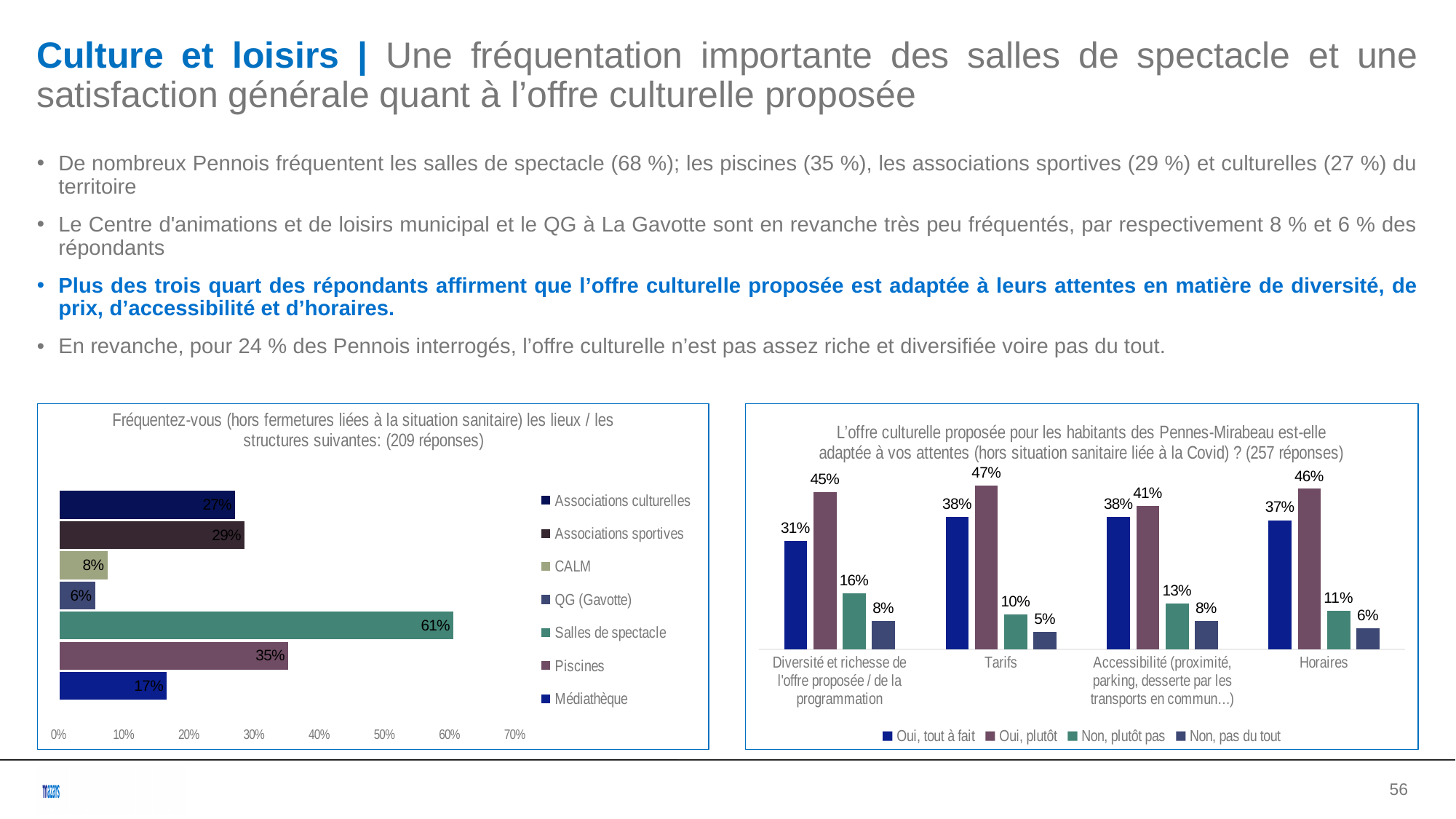
In the right chart (L'offre culturelle proposée...), what is the difference between 'Non, plutôt pas' for Diversité et richesse de l'offre proposée and for Tarifs? 6% In the left chart (Fréquentez-vous...), which place or structure has the lowest value? QG (Gavotte) What kind of chart is the left chart (Fréquentez-vous...)? Bar chart In the right chart (L'offre culturelle proposée...), what is the value of 'Non, pas du tout' for Horaires? 6% In the left chart (Fréquentez-vous...), which place or structure has the highest value? Salles de spectacle In the right chart (L'offre culturelle proposée...), what is the value of 'Oui, plutôt' for Tarifs? 47% In the left chart (Fréquentez-vous...), what is the difference between Associations sportives and Associations culturelles? 2% In the right chart (L'offre culturelle proposée...), how many series does the legend list? 4 In the right chart (L'offre culturelle proposée...), which is larger for Accessibilité: 'Oui, tout à fait' or 'Oui, plutôt'? Oui, plutôt In the left chart (Fréquentez-vous...), what is the value for Salles de spectacle? 61% In the left chart (Fréquentez-vous...), how many entries does the legend list? 7 In the left chart (Fréquentez-vous...), what is the value for Piscines? 35%